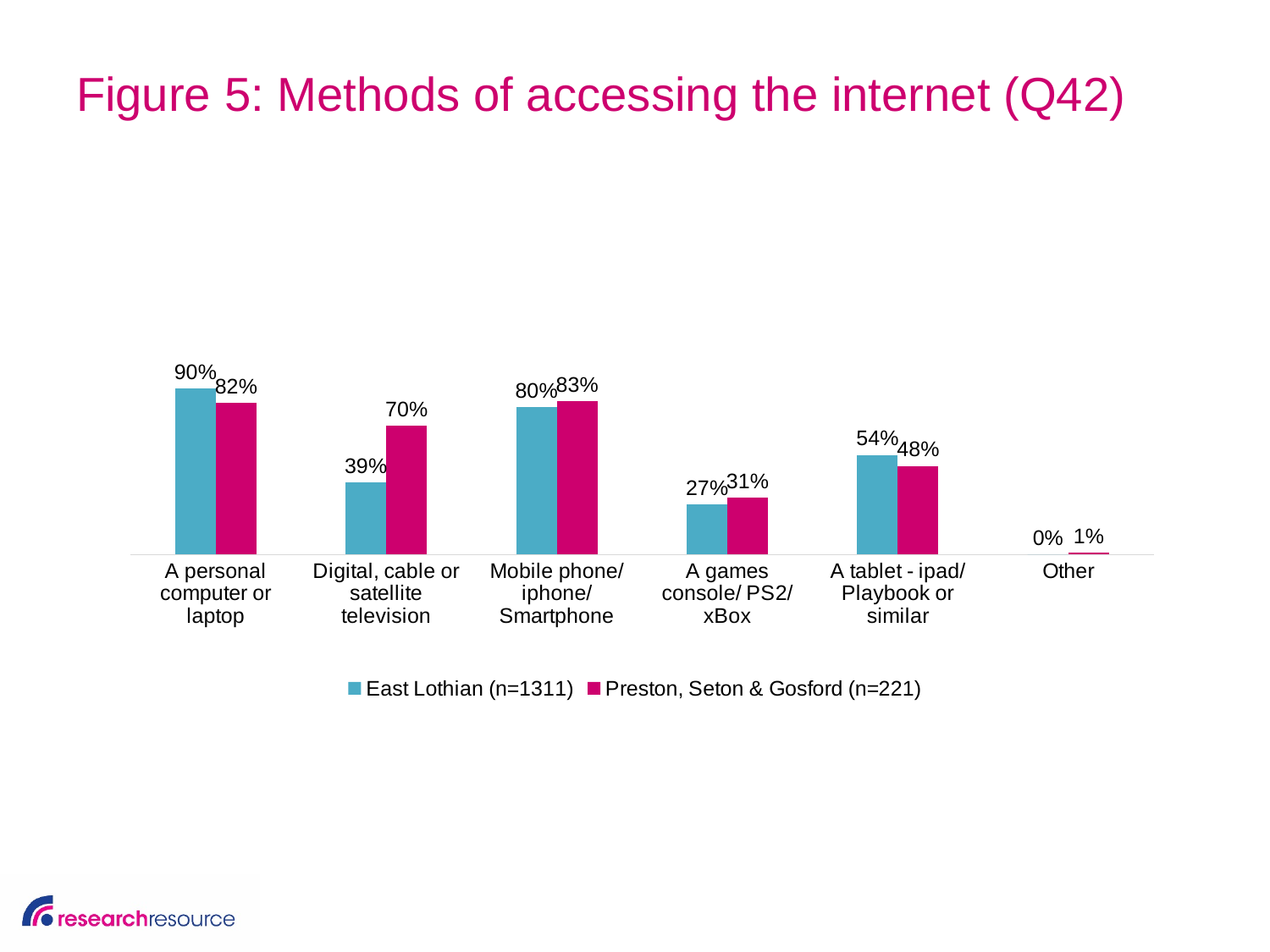
What is the value for Preston, Seton & Gosford for 'Digital, cable or satellite television'? 70% Which category has the highest value for East Lothian? A personal computer or laptop What is the sample size (n) for the Preston, Seton & Gosford series shown in the legend? 221 What is the difference between the East Lothian and Preston, Seton & Gosford values for 'Digital, cable or satellite television'? 31 percentage points How many categories are shown on the x axis? 6 What type of chart is shown? Bar chart What is the value for East Lothian for 'A games console/ PS2/ xBox'? 27% What percentage of East Lothian respondents access the internet via a personal computer or laptop? 90% For 'Mobile phone/ iphone/ Smartphone', which group has the higher value? Preston, Seton & Gosford Which category has the lowest value for Preston, Seton & Gosford? Other For 'A tablet - ipad/ Playbook or similar', which group has the higher value? East Lothian How many series does the legend list? 2